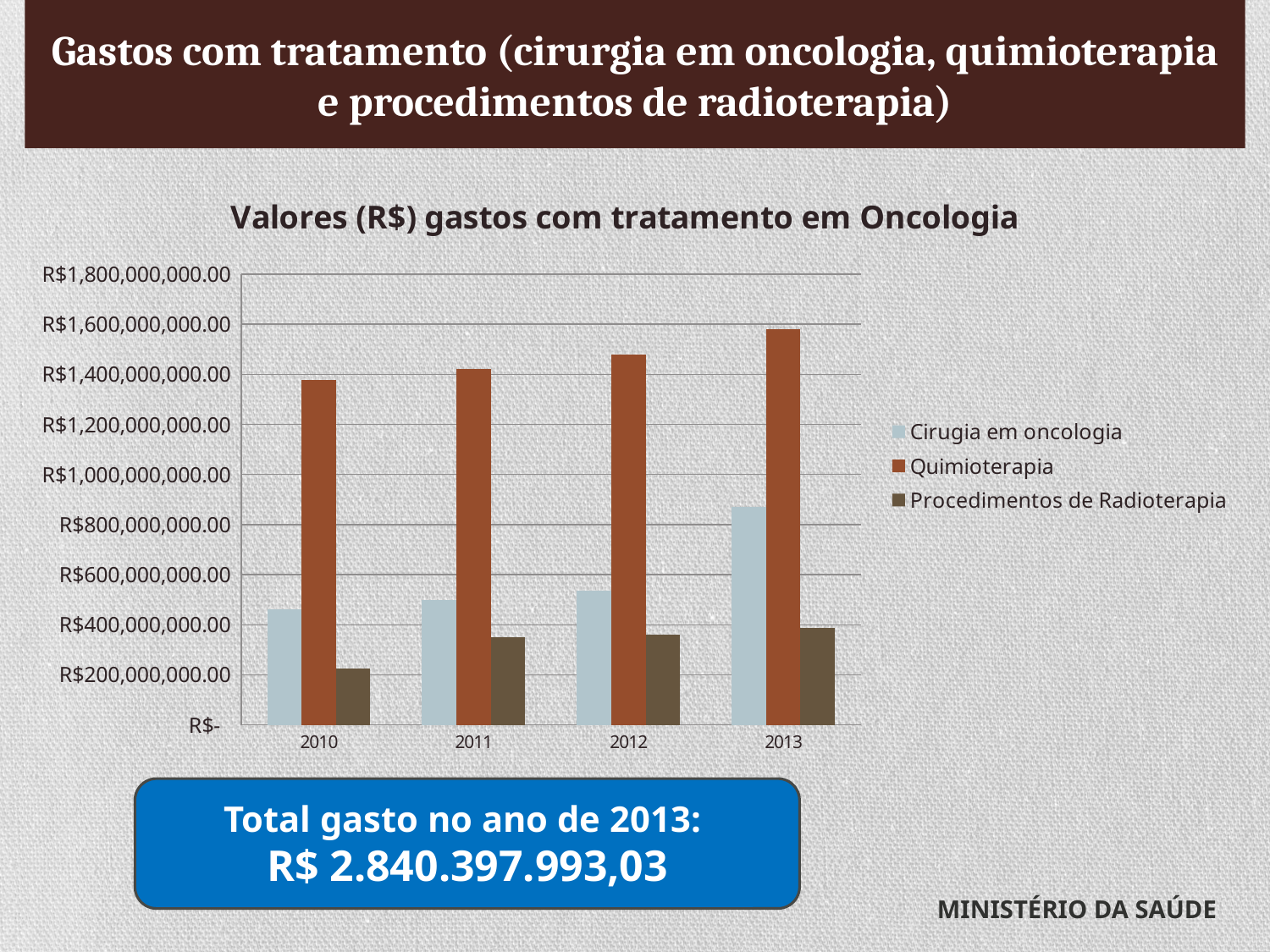
How many years are shown on the x axis? 4 Is the value for Cirugia em oncologia in 2012 greater or less than R$600,000,000.00? less Is the value for Cirugia em oncologia in 2013 greater or less than R$800,000,000.00? greater Which series has the highest value in every year? Quimioterapia Is the value for Quimioterapia in 2013 greater or less than R$1,400,000,000.00? greater Do the Quimioterapia values rise or fall from 2010 to 2013? rise Which series is shown in orange-brown bars? Quimioterapia In which year is the Procedimentos de Radioterapia bar lowest? 2010 In which year is the Quimioterapia bar highest? 2013 What is the title of the chart? Valores (R$) gastos com tratamento em Oncologia What kind of chart is shown on the slide? bar chart How many series does the legend list? 3